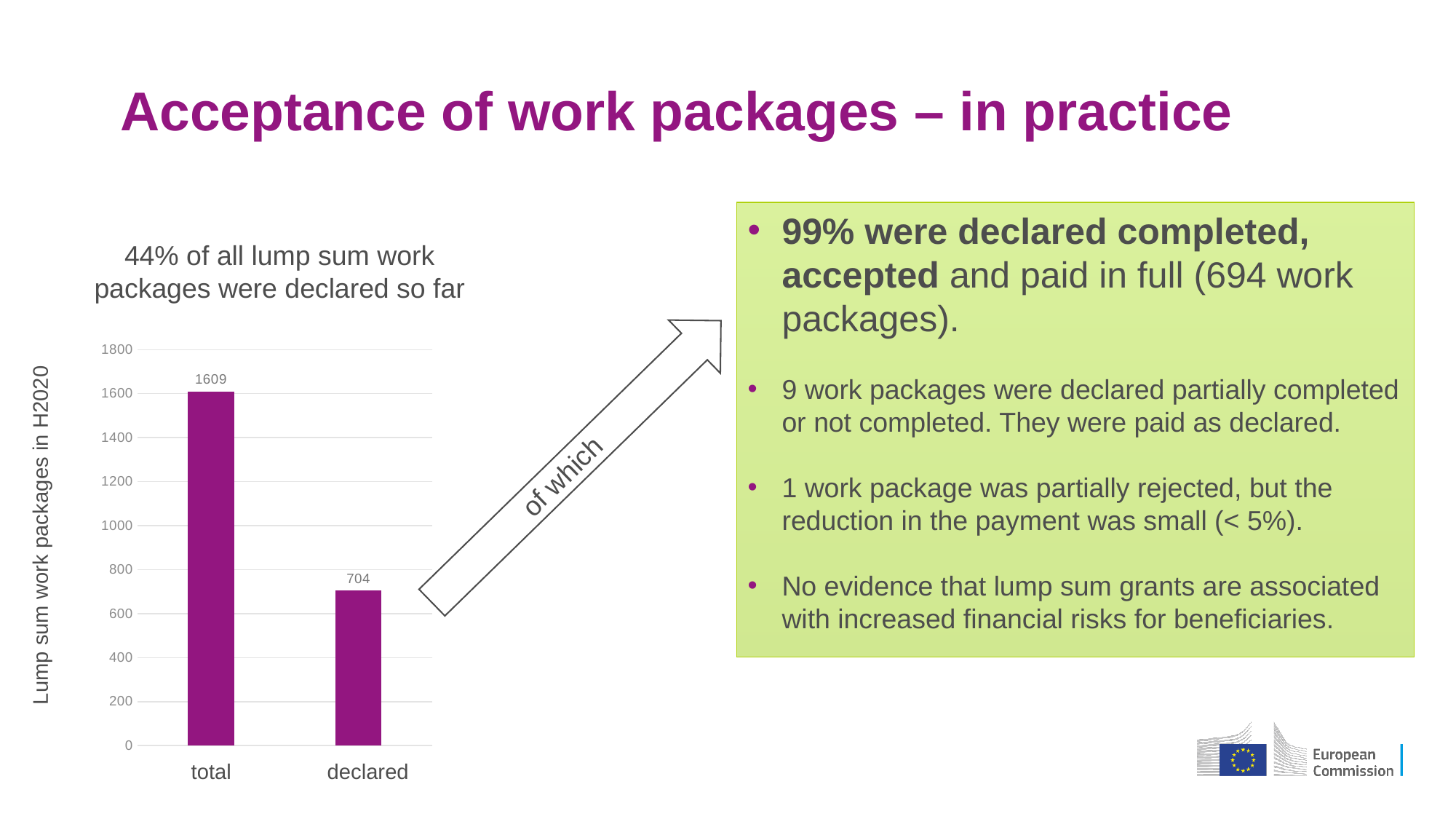
Which category has the lowest value? declared Which is larger, the value for 'total' or the value for 'declared'? total Which category has the highest value? total What is the label of the vertical axis? Lump sum work packages in H2020 Is the value for 'total' greater or less than 1400? greater What is the difference between the 'total' and 'declared' values? 905 What is the title shown above the chart? 44% of all lump sum work packages were declared so far What is the value of the 'total' bar? 1609 How many categories are shown on the x axis? 2 What is the value of the 'declared' bar? 704 What kind of chart is shown on the slide? bar chart Is the value for 'declared' greater or less than 800? less